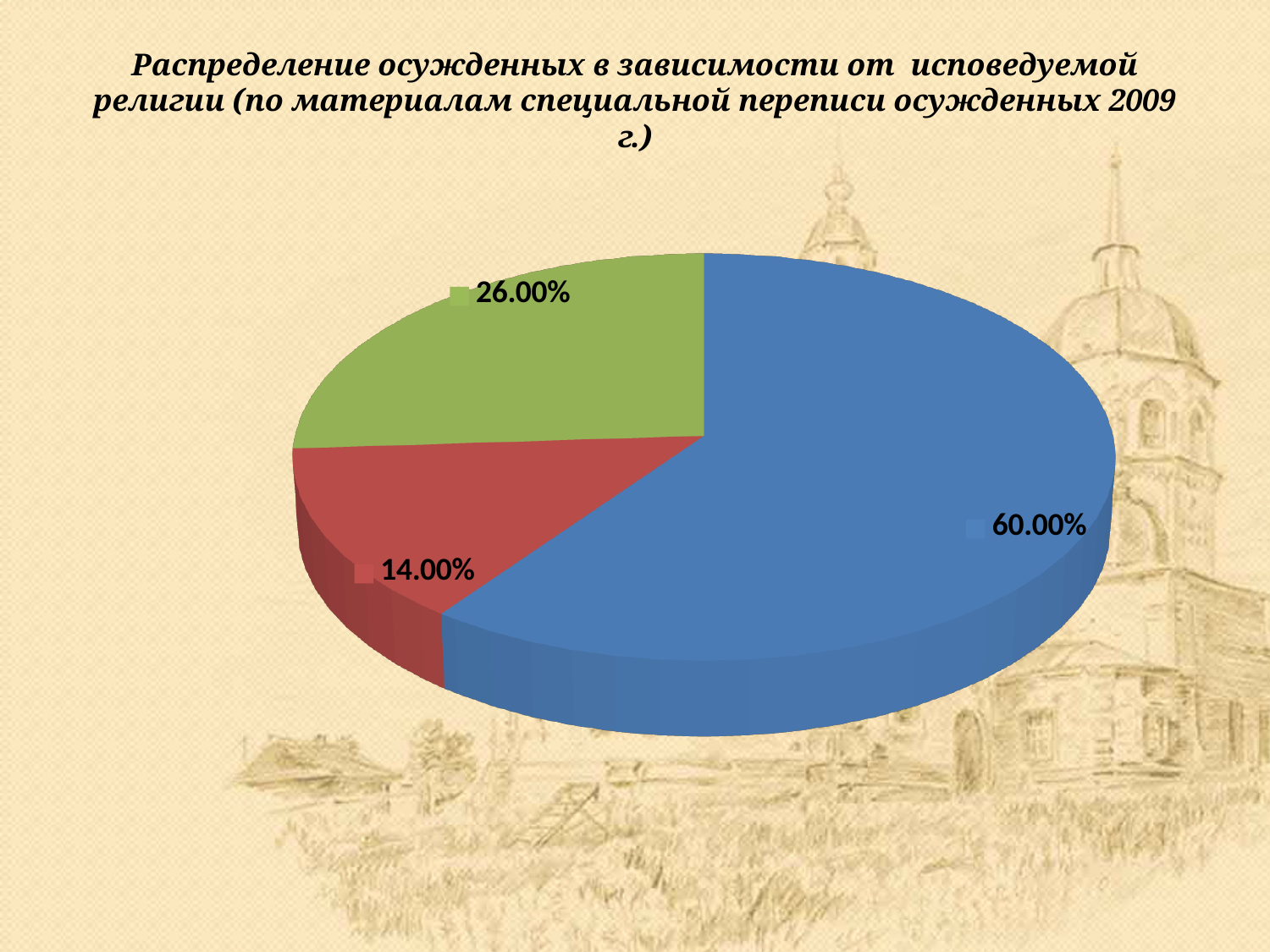
How many slices does the pie chart have? 3 Which slice of the pie chart is the smallest? the red slice (14.00%) What percentage is shown for the green slice of the pie chart? 26.00% What percentage is shown for the blue slice of the pie chart? 60.00% According to the slide title, from which year's special census of convicts is the data taken? 2009 Which slice of the pie chart is the largest? the blue slice (60.00%) What kind of chart is shown on the slide? pie chart What is the difference between the blue slice and the green slice of the pie chart? 34.00% What is the difference between the green slice and the red slice of the pie chart? 12.00% What percentage is shown for the red slice of the pie chart? 14.00% What do the three slice percentages in the pie chart add up to? 100.00% Which is larger in the pie chart, the green slice or the red slice? the green slice